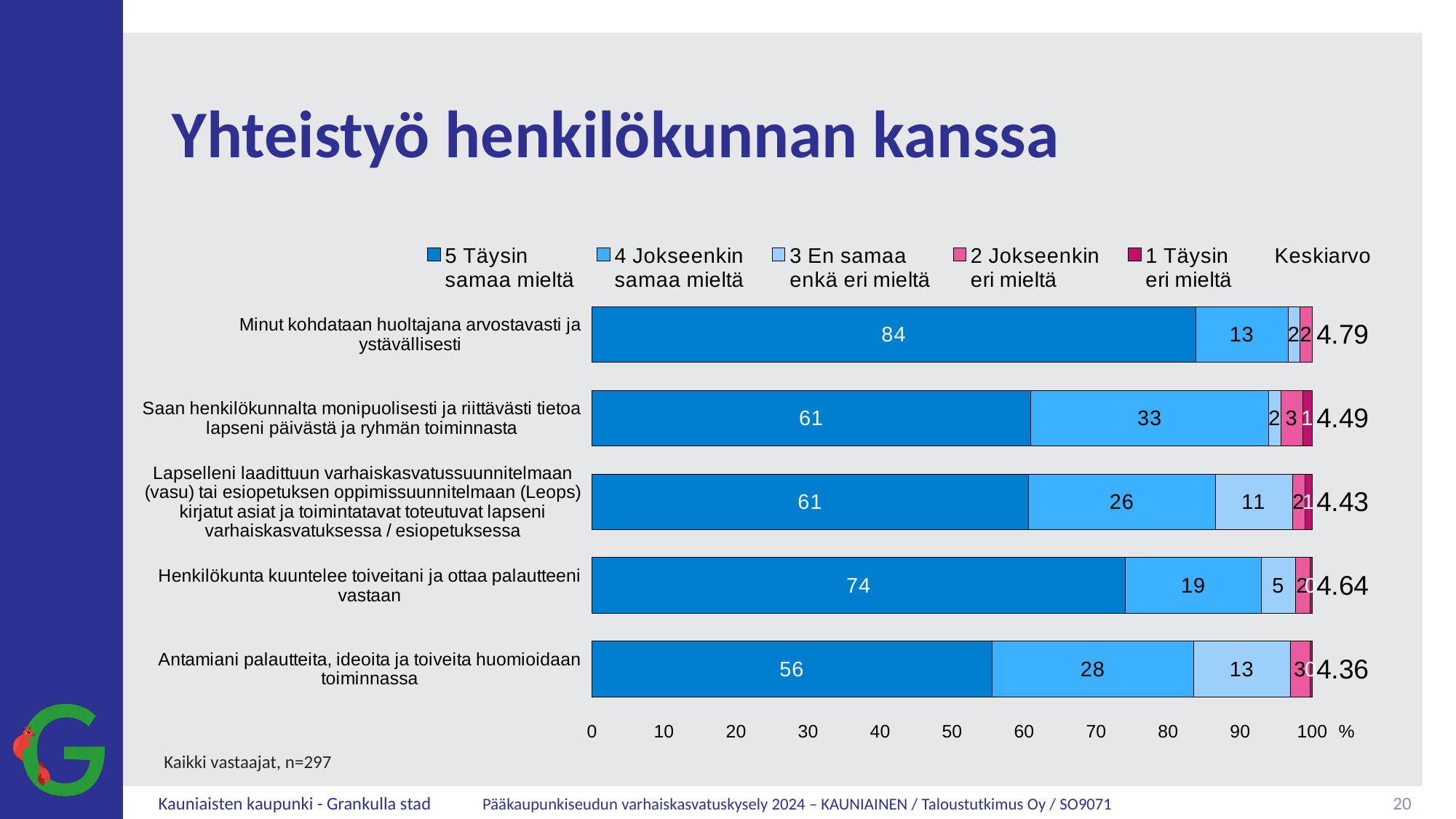
What is the "3 En samaa enkä eri mieltä" value for "Antamiani palautteita, ideoita ja toiveita huomioidaan toiminnassa"? 13 What kind of chart is shown on the slide? Stacked bar chart Which is larger: the "4 Jokseenkin samaa mieltä" value for the Lapselleni laadittuun varhaiskasvatussuunnitelmaan statement or for "Henkilökunta kuuntelee toiveitani ja ottaa palautteeni vastaan"? Lapselleni laadittuun varhaiskasvatussuunnitelmaan statement Which statement has the lowest Keskiarvo (mean) value? Antamiani palautteita, ideoita ja toiveita huomioidaan toiminnassa What is the Keskiarvo (mean) shown for "Henkilökunta kuuntelee toiveitani ja ottaa palautteeni vastaan"? 4.64 What percentage of respondents answered "5 Täysin samaa mieltä" for "Minut kohdataan huoltajana arvostavasti ja ystävällisesti"? 84 What is the difference between the "5 Täysin samaa mieltä" values for "Minut kohdataan huoltajana arvostavasti ja ystävällisesti" and "Antamiani palautteita, ideoita ja toiveita huomioidaan toiminnassa"? 28 What is the "4 Jokseenkin samaa mieltä" value for "Saan henkilökunnalta monipuolisesti ja riittävästi tietoa lapseni päivästä ja ryhmän toiminnasta"? 33 What is the highest Keskiarvo (mean) value shown in the chart? 4.79 Which statement has the highest "5 Täysin samaa mieltä" share? Minut kohdataan huoltajana arvostavasti ja ystävällisesti How many statements (bars) are shown in the chart? 5 How many response categories does the legend list (excluding Keskiarvo)? 5